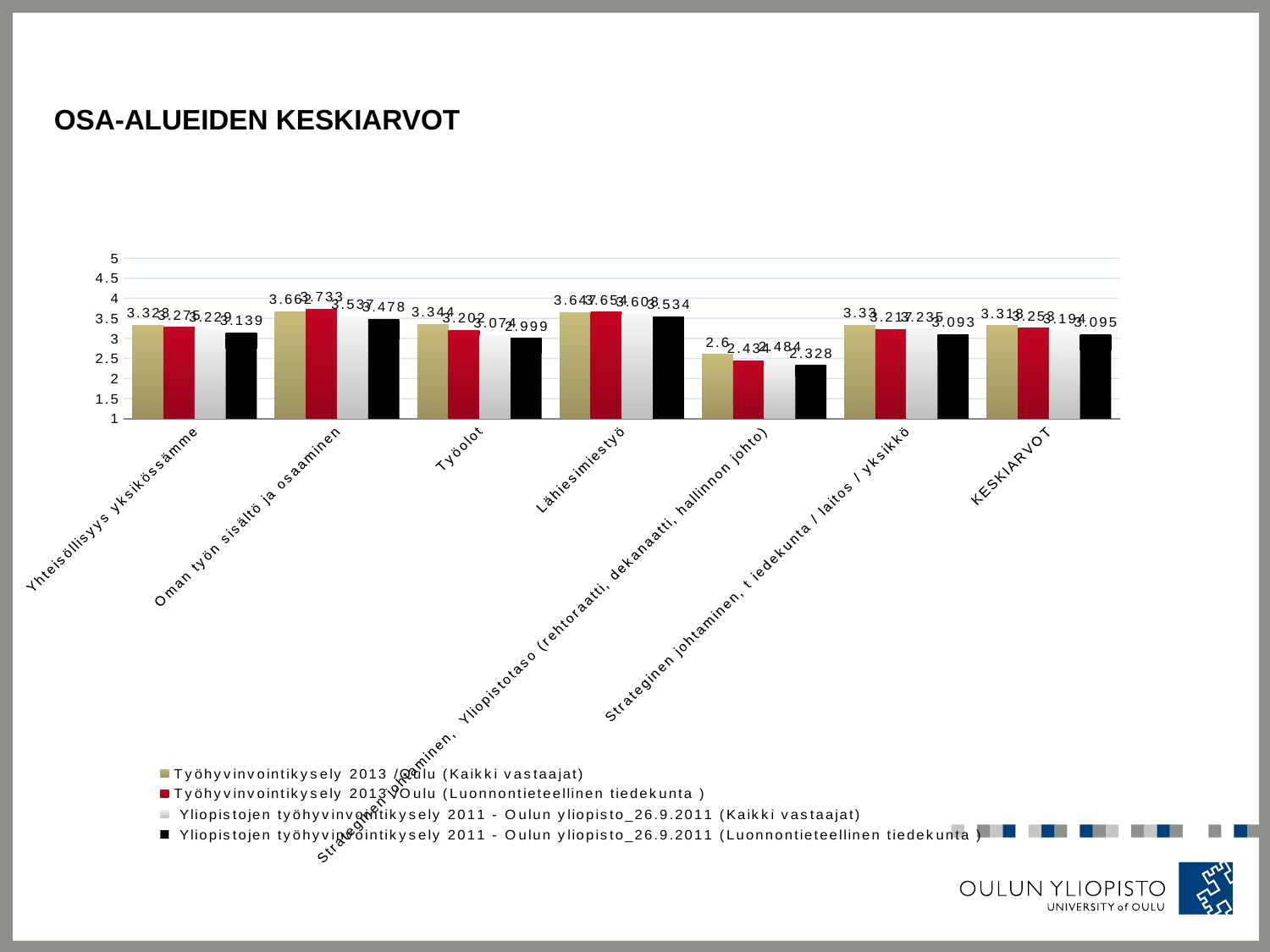
What is the value for Työolot in the series Yliopistojen työhyvinvointikysely 2011 - Oulun yliopisto_26.9.2011 (Luonnontieteellinen tiedekunta)? 2.999 How many categories are shown on the x axis? 7 What kind of chart is shown on the slide? bar chart Is the value for Lähiesimiestyö in the series Työhyvinvointikysely 2013 / Oulu (Kaikki vastaajat) greater or less than 3.5? greater What is the title of the slide? OSA-ALUEIDEN KESKIARVOT For Työolot, which is larger: the value for Työhyvinvointikysely 2013 / Oulu (Kaikki vastaajat) or for Yliopistojen työhyvinvointikysely 2011 - Oulun yliopisto_26.9.2011 (Luonnontieteellinen tiedekunta)? Työhyvinvointikysely 2013 / Oulu (Kaikki vastaajat) Which category has the lowest value in the series Yliopistojen työhyvinvointikysely 2011 - Oulun yliopisto_26.9.2011 (Luonnontieteellinen tiedekunta)? Strateginen johtaminen, Yliopistotaso (rehtoraatti, dekanaatti, hallinnon johto) How many series does the legend list? 4 What is the KESKIARVOT value for the series Yliopistojen työhyvinvointikysely 2011 - Oulun yliopisto_26.9.2011 (Luonnontieteellinen tiedekunta)? 3.095 What is the value for Strateginen johtaminen, Yliopistotaso (rehtoraatti, dekanaatti, hallinnon johto) in the series Yliopistojen työhyvinvointikysely 2011 - Oulun yliopisto_26.9.2011 (Luonnontieteellinen tiedekunta)? 2.328 What is the value for Lähiesimiestyö in the series Työhyvinvointikysely 2013 / Oulu (Kaikki vastaajat)? 3.647 In the series Yliopistojen työhyvinvointikysely 2011 - Oulun yliopisto_26.9.2011 (Luonnontieteellinen tiedekunta), what is the difference between the values for Yhteisöllisyys yksikössämme and Työolot? 0.14